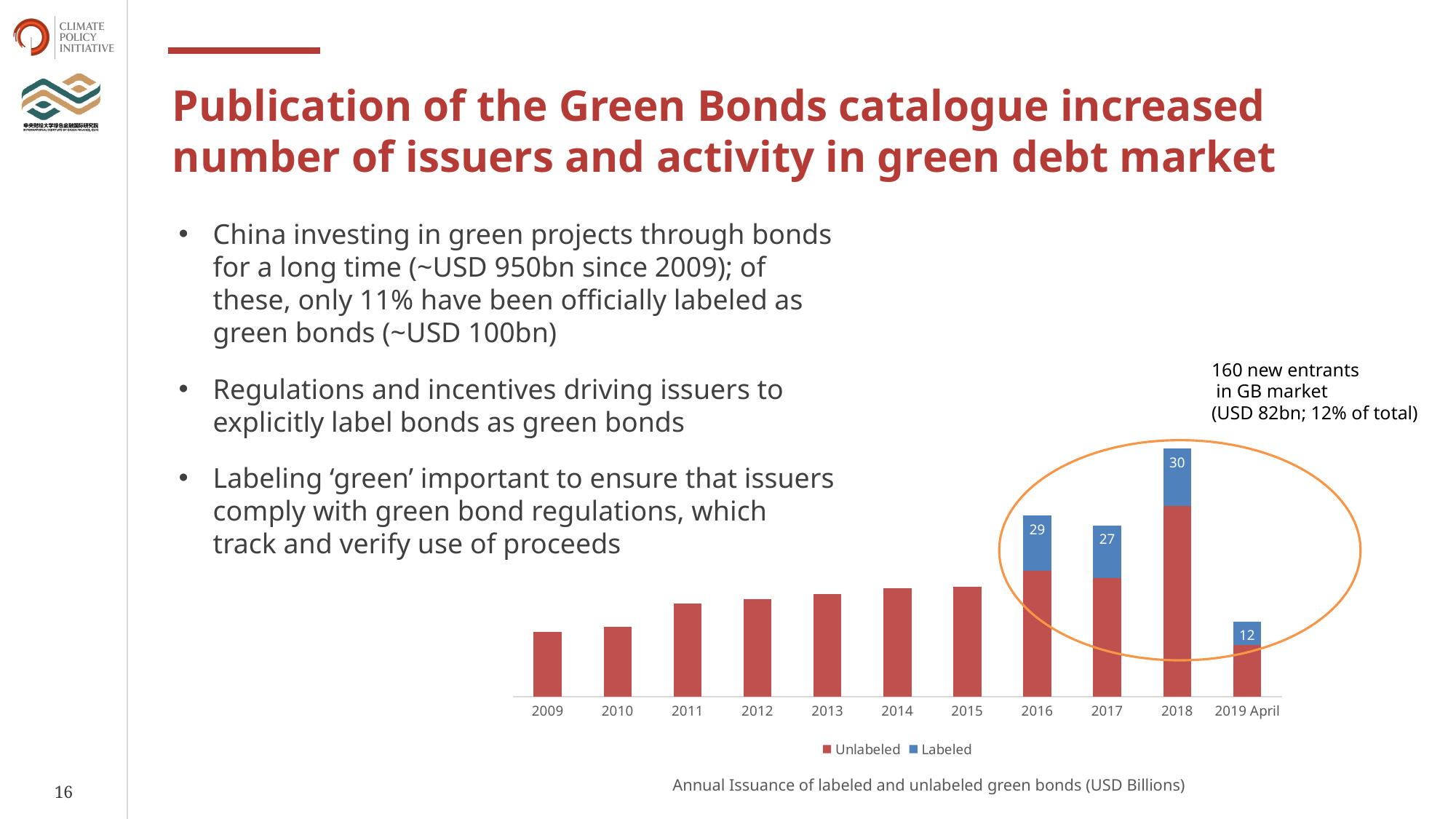
What is the Labeled value for 2017? 27 How many series does the legend list? 2 What is the difference between the Labeled values for 2018 and 2019 April? 18 What is the Labeled value for 2016? 29 Do the Unlabeled bars rise or fall from 2009 to 2015? Rise What kind of chart is shown on the slide? Stacked bar chart What is the Labeled value for 2019 April? 12 Which year has the highest Labeled value? 2018 Which year has the larger Labeled value, 2016 or 2017? 2016 How many categories are shown on the x axis? 11 What is the Labeled value for 2018? 30 Which category has the lowest Labeled value among those with a printed label? 2019 April